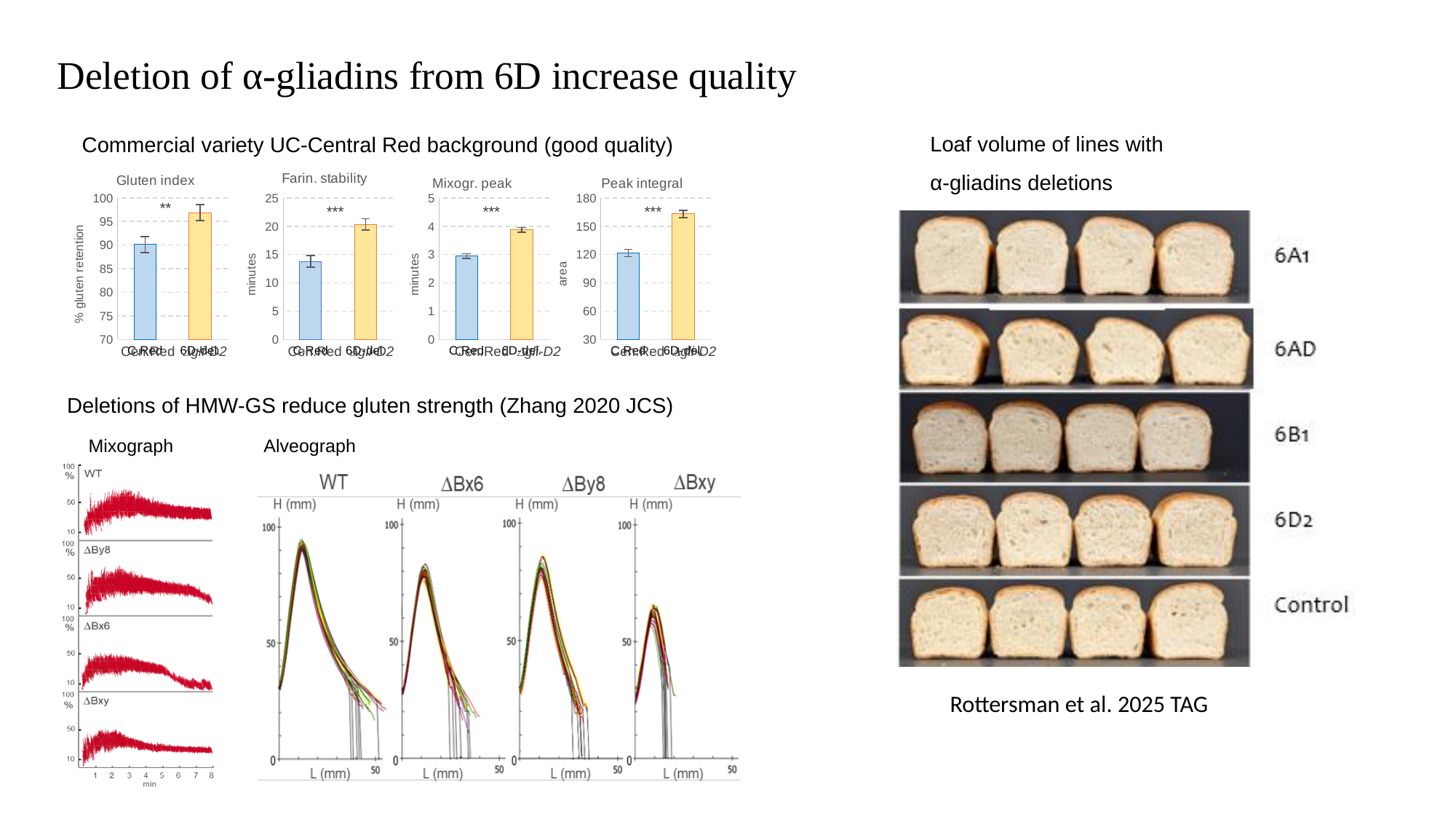
In the Gluten index chart, is the value for the C.Red (blue) bar greater or less than 85? greater In the Farin. stability chart, is the value for the C.Red (blue) bar greater or less than 15? less What kind of chart is the Mixogr. peak chart? bar chart In the Peak integral chart, is the value for the 6D-del (orange) bar greater or less than 150? greater In the Gluten index chart, which bar is higher, C.Red (blue) or 6D-del (orange)? 6D-del (orange) What is the highest y-axis tick value shown on the Peak integral chart? 180 How many bars are plotted in the Farin. stability chart? 2 What is the y-axis label of the Gluten index chart? % gluten retention In the Peak integral chart, which bar is higher, C.Red (blue) or 6D-del (orange)? 6D-del (orange)